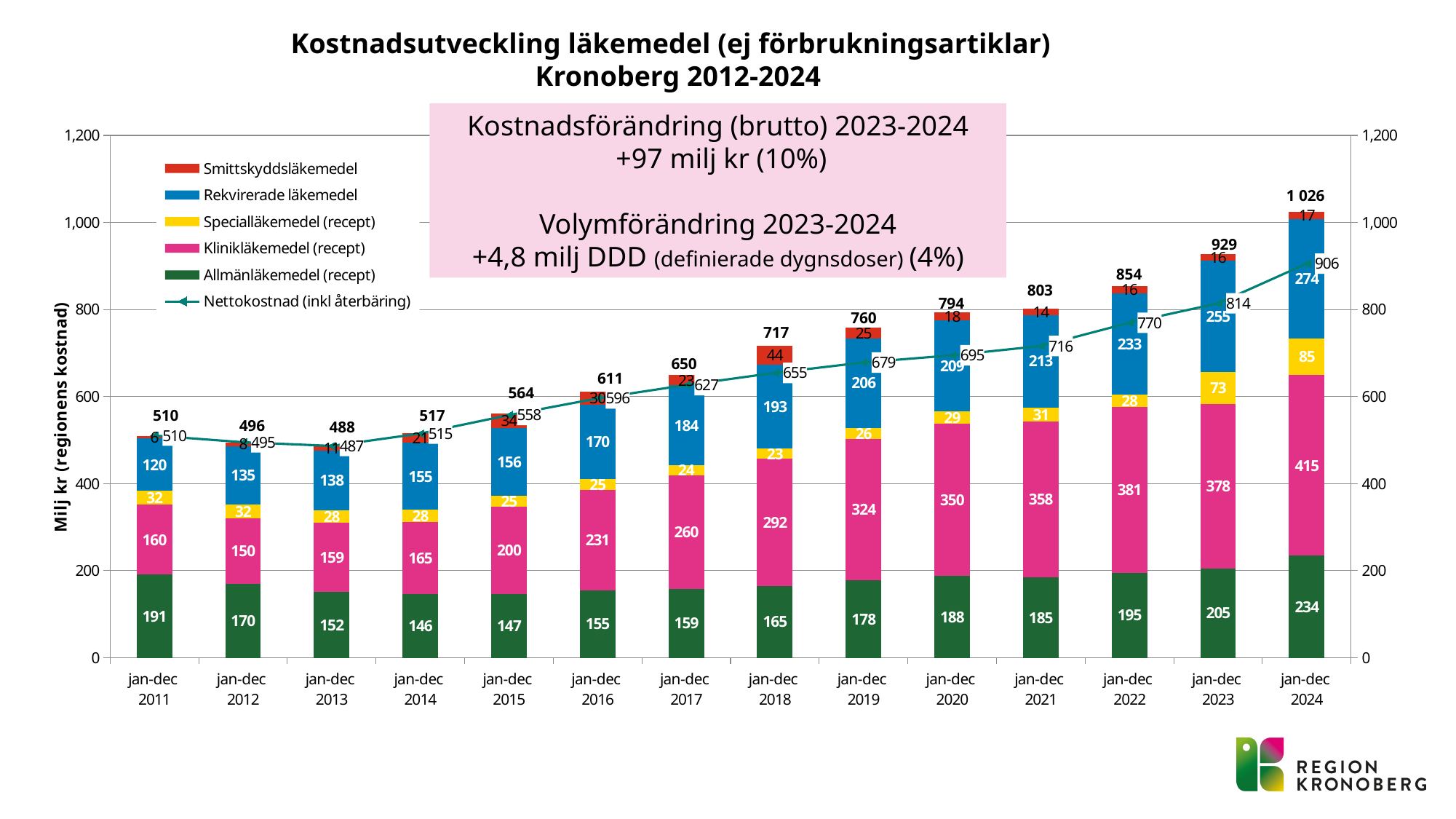
What is the value of Rekvirerade läkemedel for jan-dec 2016? 170 Which year has the highest value for Smittskyddsläkemedel? jan-dec 2018 Does the Nettokostnad line rise or fall from jan-dec 2013 to jan-dec 2024? Rise Which year has the lowest total cost? jan-dec 2013 Is the Specialläkemedel (recept) value larger in jan-dec 2023 or jan-dec 2022? jan-dec 2023 What is the difference between the Allmänläkemedel (recept) values for jan-dec 2024 and jan-dec 2011? 43 How many series does the legend list? 6 What is the total cost shown above the bar for jan-dec 2024? 1 026 What is the Nettokostnad (inkl återbäring) value for jan-dec 2023? 814 What is the value of Klinikläkemedel (recept) for jan-dec 2019? 324 What kind of chart is this? Stacked bar chart with a line How many years (categories) are shown on the x axis? 14